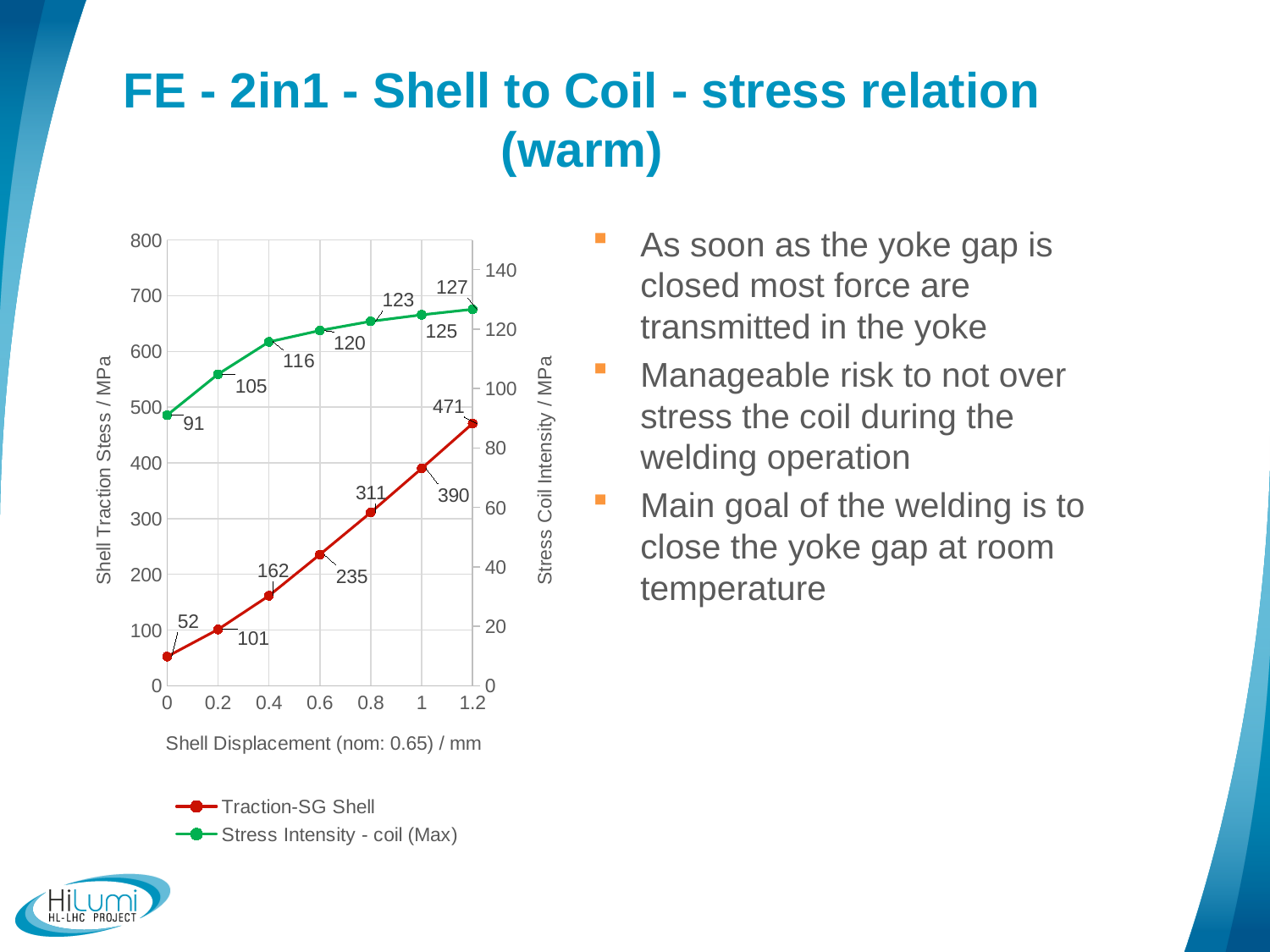
At which shell displacement is the Traction-SG Shell value lowest? 0 What is the Stress Intensity - coil (Max) value at a shell displacement of 0 mm? 91 What is the Stress Intensity - coil (Max) value at a shell displacement of 0.8 mm? 123 What is the Traction-SG Shell value at a shell displacement of 0.6 mm? 235 How many series does the legend list? 2 How many data points are plotted for the Traction-SG Shell series? 7 What type of chart is shown on the slide? line chart At which shell displacement is the Stress Intensity - coil (Max) value highest? 1.2 Does the Stress Intensity - coil (Max) series rise or fall as shell displacement increases? rise What is the label of the right-hand vertical axis? Stress Coil Intensity / MPa What is the difference between the Traction-SG Shell values at 1.2 mm and 0 mm displacement? 419 What is the Traction-SG Shell value at a shell displacement of 1.2 mm? 471